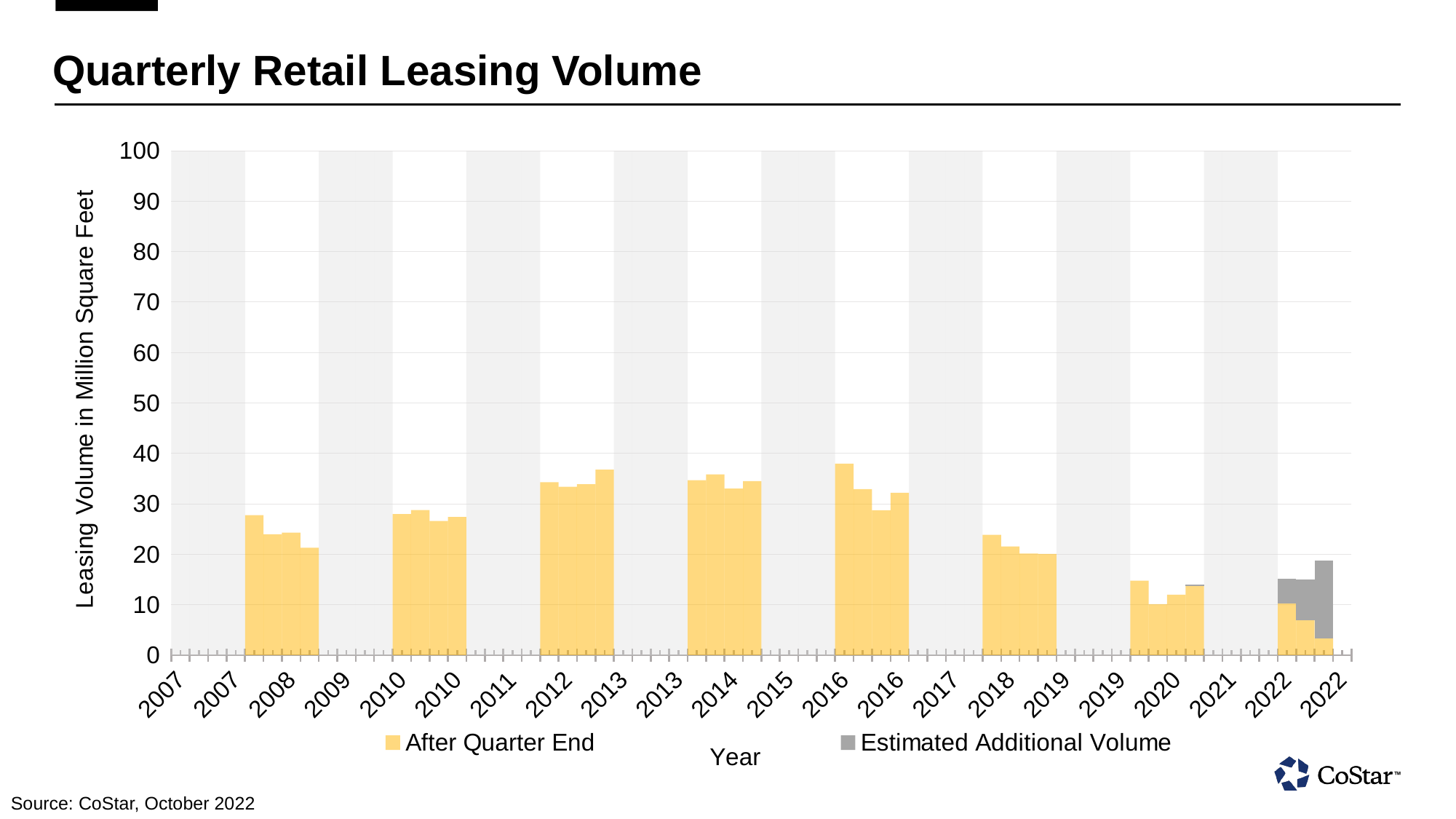
Are the bars in the 2018 group greater or less than 10? greater How many series does the legend list? 2 Which year group has the lowest After Quarter End bar? 2022 Is the tallest bar in the 2016 group greater or less than 40? less Is the tallest bar in the 2016 group greater or less than 30? greater Which is larger, the After Quarter End volume in the 2012 group or in the 2008 group? 2012 Do the bar heights generally rise or fall from 2016 to 2022? fall What kind of chart is shown on the slide? Bar chart What are the two series named in the legend? After Quarter End; Estimated Additional Volume What is the title of the vertical axis? Leasing Volume in Million Square Feet